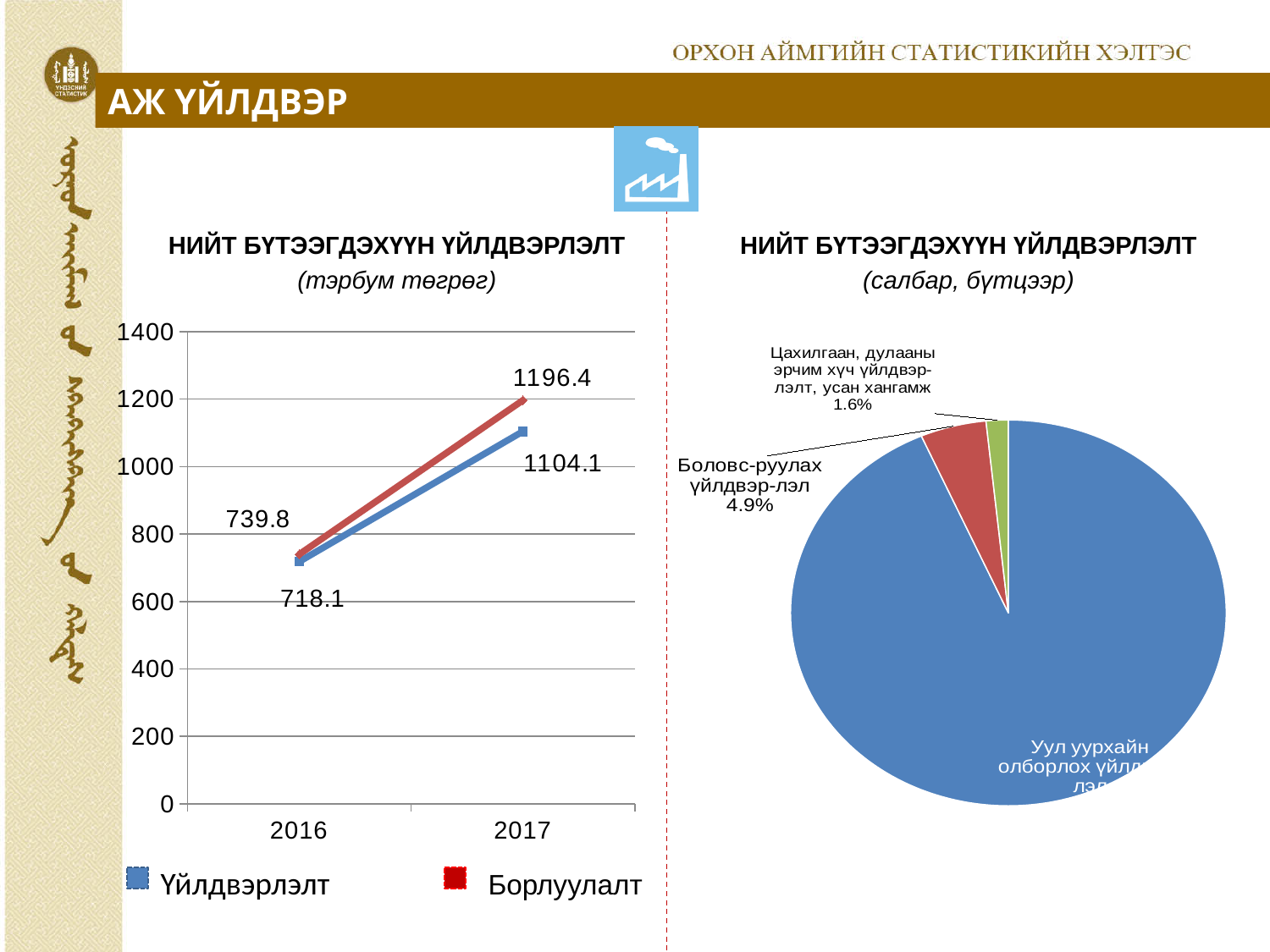
How many series does the legend of the left line chart list? 2 In the right pie chart, which slice is the largest? Уул уурхайн олборлох үйлдвэрлэл What kind of chart is the left chart titled 'НИЙТ БҮТЭЭГДЭХҮҮН ҮЙЛДВЭРЛЭЛТ (тэрбум төгрөг)'? Line chart In the right pie chart, what share does Боловсруулах үйлдвэрлэл have? 4.9% In the left line chart, what is the value of Үйлдвэрлэлт in 2017? 1104.1 In the left line chart, what is the difference between Борлуулалт and Үйлдвэрлэлт in 2017? 92.3 In the left line chart, by how much did Үйлдвэрлэлт increase from 2016 to 2017? 386.0 What kind of chart is the right chart titled 'НИЙТ БҮТЭЭГДЭХҮҮН ҮЙЛДВЭРЛЭЛТ (салбар, бүтцээр)'? Pie chart In the left line chart, does the Үйлдвэрлэлт series rise or fall from 2016 to 2017? Rise In the left line chart, what is the value of Борлуулалт in 2016? 739.8 In the right pie chart, what share does Цахилгаан, дулааны эрчим хүч үйлдвэрлэлт, усан хангамж have? 1.6% In the left line chart, which series has the larger value in 2016, Үйлдвэрлэлт or Борлуулалт? Борлуулалт